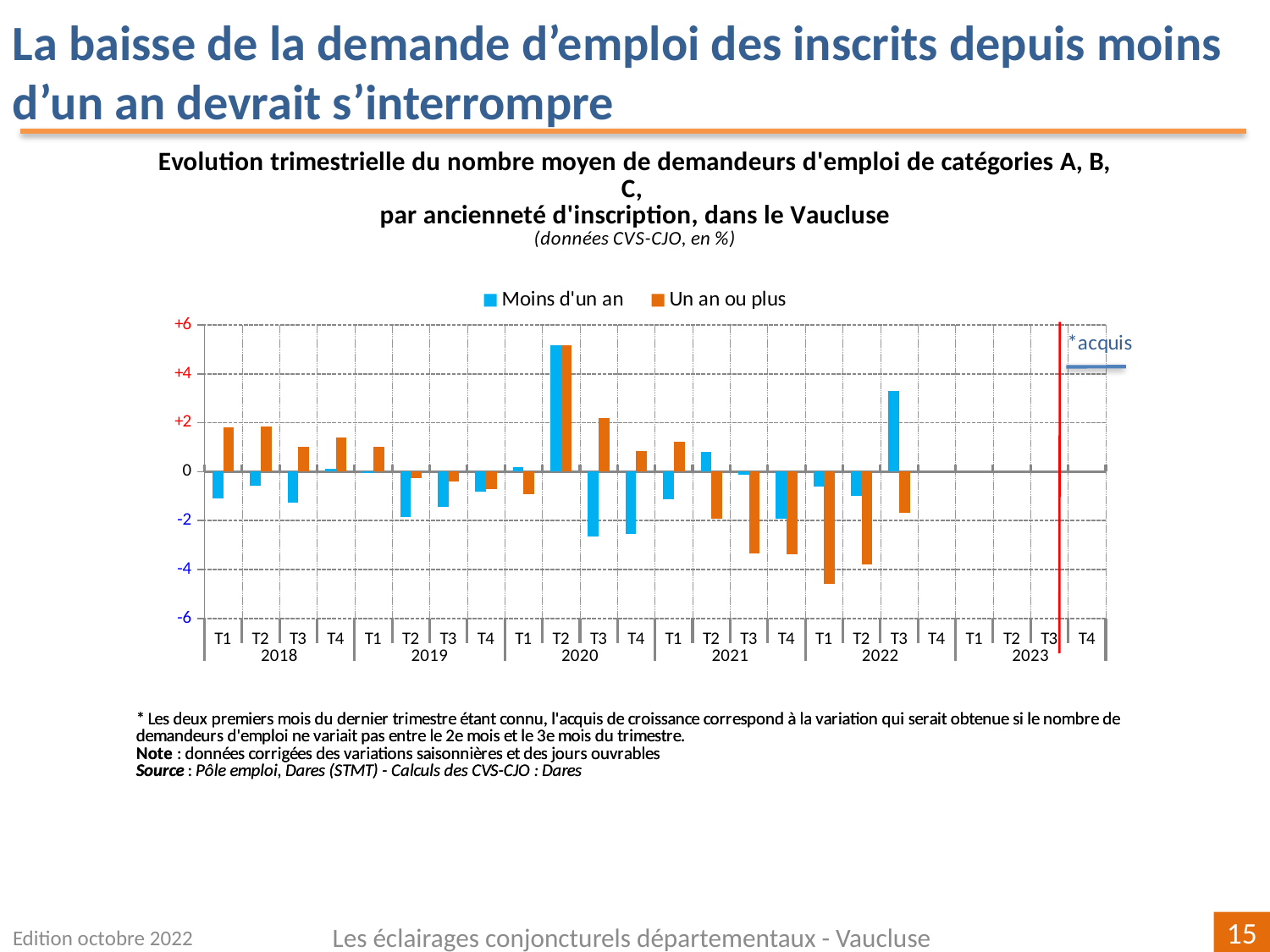
In which quarter is the 'Un an ou plus' series at its lowest value? T1 2022 How many years are labelled along the x axis of the chart? 6 In T3 2020, which series has the larger value, 'Moins d'un an' or 'Un an ou plus'? Un an ou plus Is the value for 'Un an ou plus' in T1 2022 greater or less than -4? less Is the value for 'Moins d'un an' in T3 2022 greater or less than +2? greater In which quarter is the 'Moins d'un an' series at its highest value? T2 2020 In T3 2022, which series has the larger value, 'Moins d'un an' or 'Un an ou plus'? Moins d'un an How many series does the legend list? 2 Is the value for 'Moins d'un an' in T2 2020 greater or less than +4? greater What kind of chart is shown on the slide? Bar chart What are the two series named in the legend? Moins d'un an; Un an ou plus